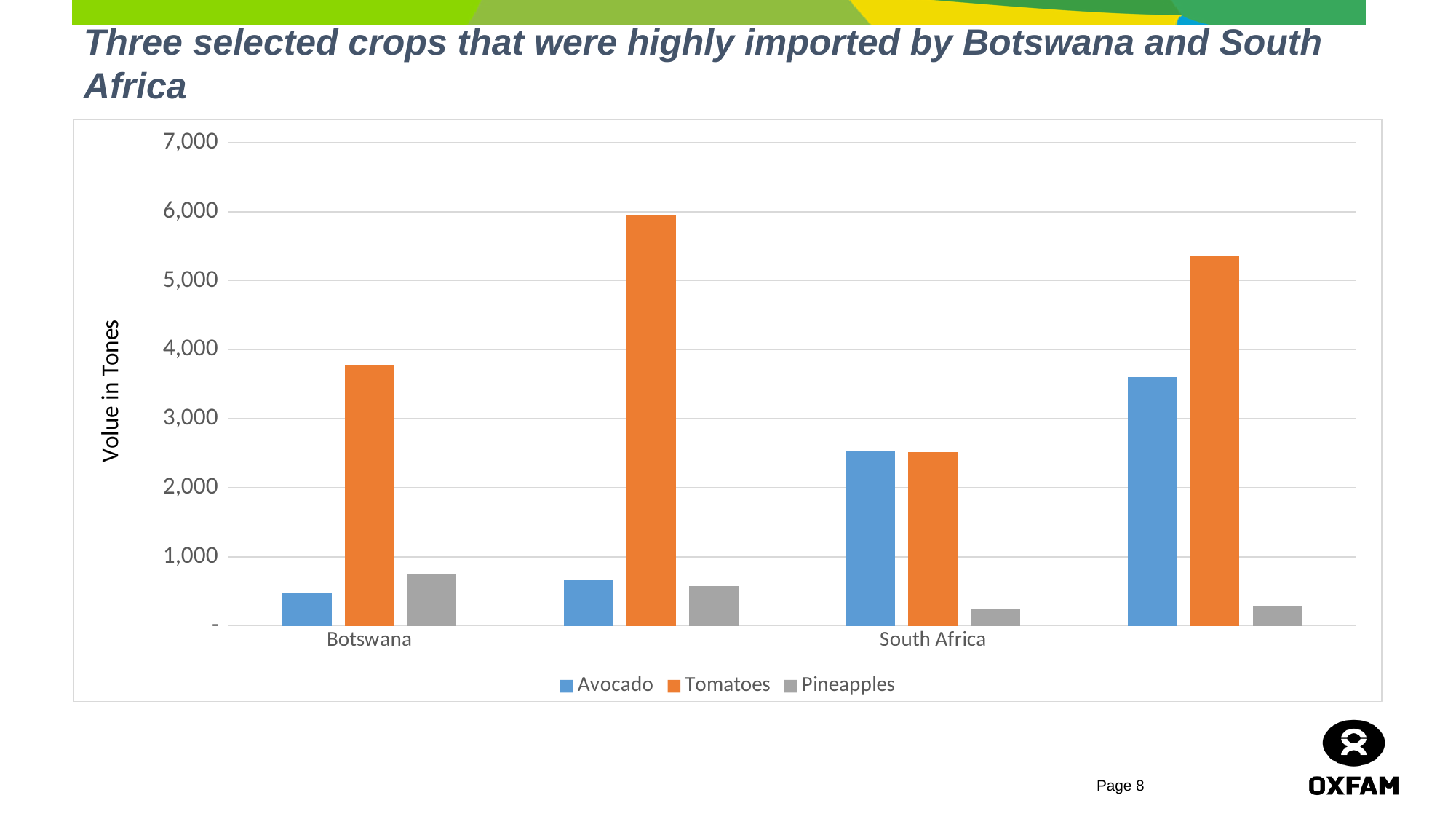
Is the Tomatoes value for Botswana greater or less than 4,000? less What is the title of the vertical axis? Volue in Tones What kind of chart is shown on the slide? bar chart For Botswana, which is larger, the Tomatoes value or the Avocado value? Tomatoes How many series does the legend list? 3 Is the Pineapples value for South Africa greater or less than 1,000? less Which crop has the highest value for Botswana? Tomatoes Which series is shown in orange in the legend? Tomatoes Is the Tomatoes value for Botswana greater or less than 3,000? greater Which crop has the lowest value for South Africa? Pineapples